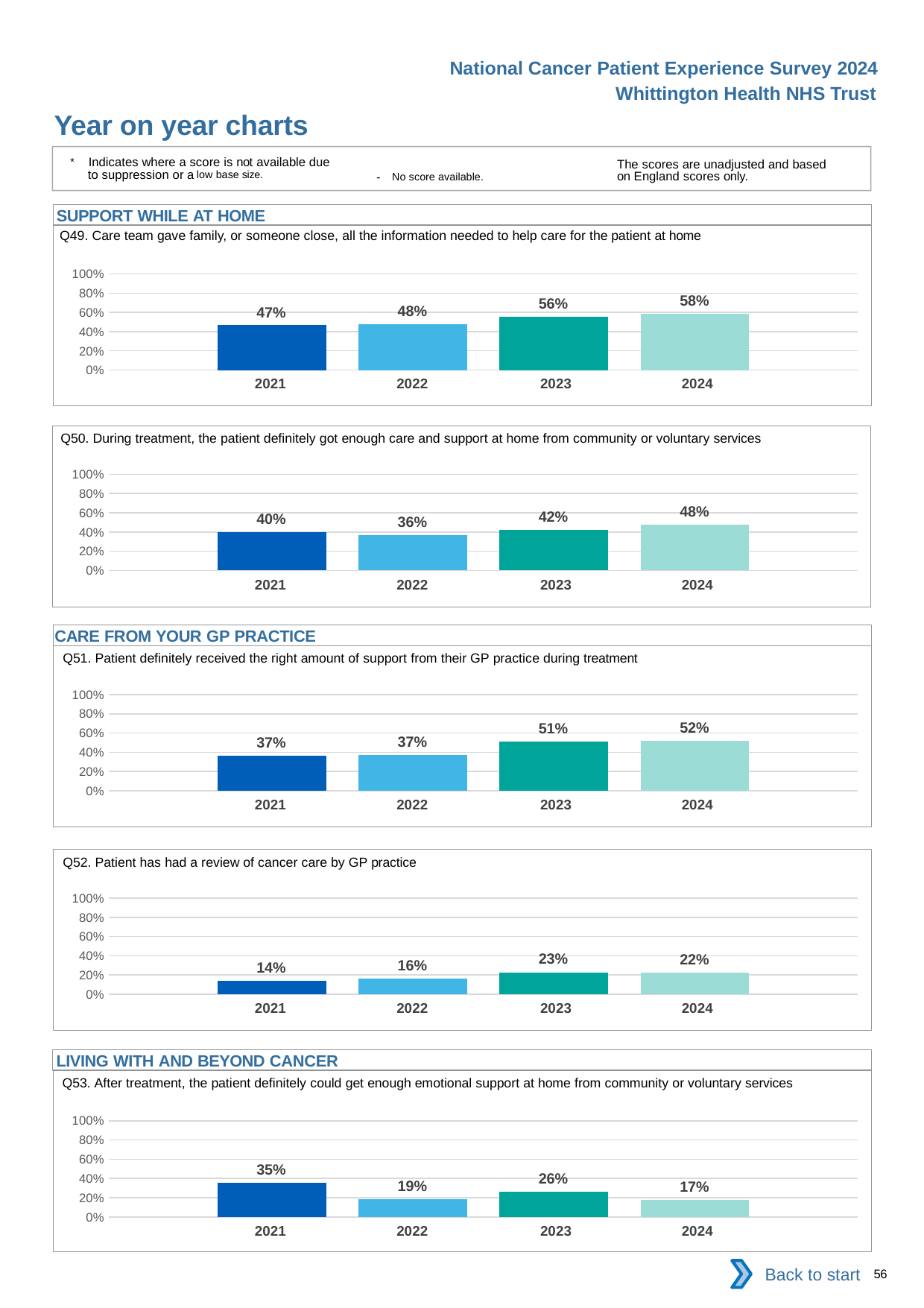
In the Q49 chart, which year has the lowest value? 2021 In the Q53 chart, what is the difference between the 2021 and 2024 values? 18% How many years are shown in the Q49 chart? 4 In the Q50 chart, what is the value for 2022? 36% What kind of chart is the Q50 chart? Bar chart In the Q52 chart, which is larger, the value for 2023 or the value for 2024? 2023 In the Q53 chart, which year has the highest value? 2021 In the Q51 chart, which year has the highest value? 2024 In the Q49 chart, what is the value for 2024? 58% In the Q51 chart, what is the value for 2021? 37% In the Q52 chart, what is the value for 2021? 14% In the Q50 chart, what is the difference between the 2024 and 2021 values? 8%